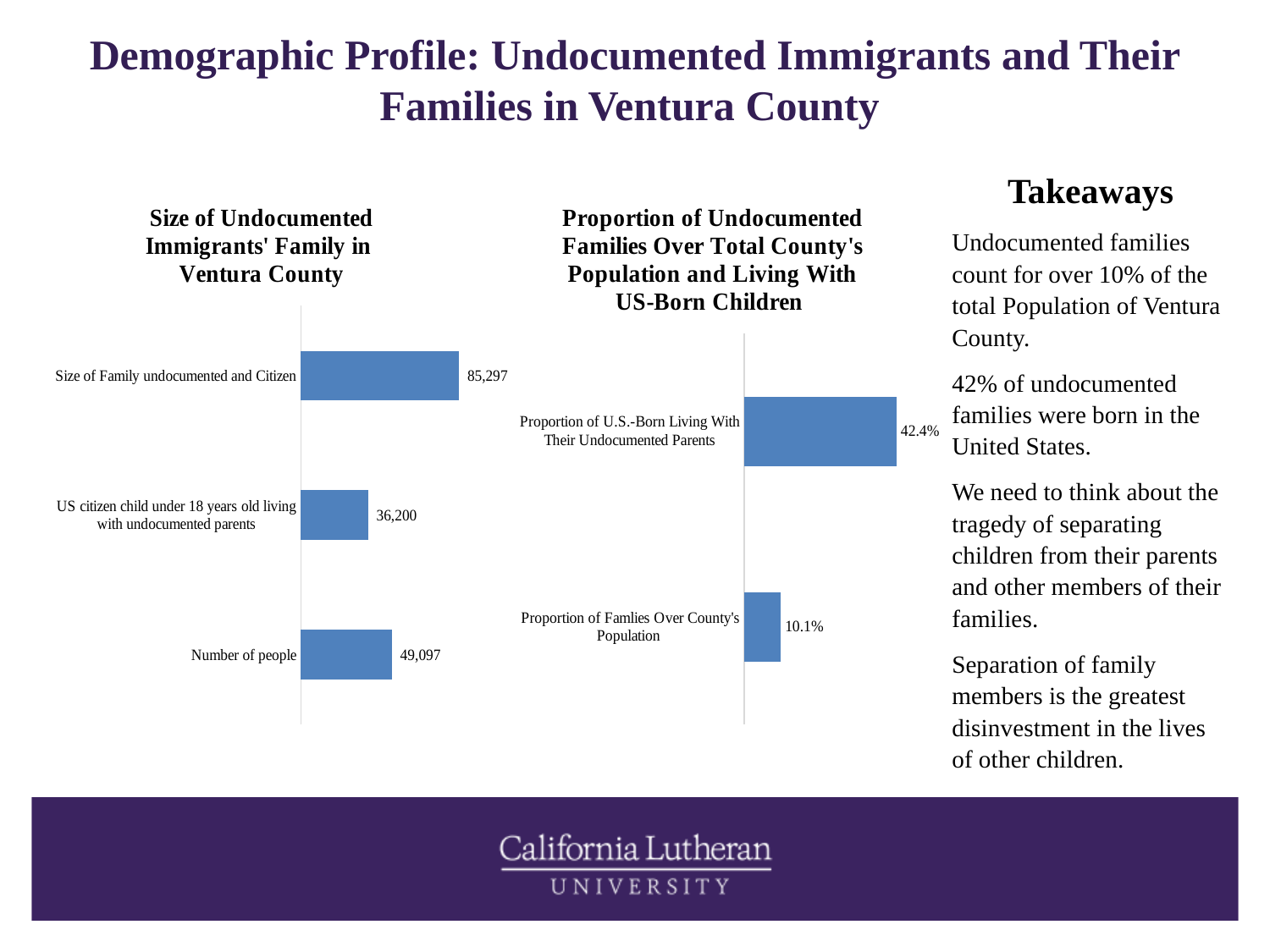
What type of chart is the 'Size of Undocumented Immigrants' Family in Ventura County' chart? Bar chart In the 'Size of Undocumented Immigrants' Family in Ventura County' chart, what is the value for 'Size of Family undocumented and Citizen'? 85,297 In the 'Size of Undocumented Immigrants' Family in Ventura County' chart, what is the value for 'Number of people'? 49,097 In the 'Proportion of Undocumented Families Over Total County's Population and Living With US-Born Children' chart, what is the value for 'Proportion of Famlies Over County's Population'? 10.1% In the 'Size of Undocumented Immigrants' Family in Ventura County' chart, how many categories are shown? 3 In the 'Size of Undocumented Immigrants' Family in Ventura County' chart, which category has the highest value? Size of Family undocumented and Citizen In the 'Size of Undocumented Immigrants' Family in Ventura County' chart, what is the value for 'US citizen child under 18 years old living with undocumented parents'? 36,200 In the 'Size of Undocumented Immigrants' Family in Ventura County' chart, which category has the lowest value? US citizen child under 18 years old living with undocumented parents In the 'Proportion of Undocumented Families Over Total County's Population and Living With US-Born Children' chart, what is the difference between the two values? 32.3% In the 'Proportion of Undocumented Families Over Total County's Population and Living With US-Born Children' chart, what is the value for 'Proportion of U.S.-Born Living With Their Undocumented Parents'? 42.4% In the 'Proportion of Undocumented Families Over Total County's Population and Living With US-Born Children' chart, which category has the larger value? Proportion of U.S.-Born Living With Their Undocumented Parents In the 'Size of Undocumented Immigrants' Family in Ventura County' chart, what is the difference between 'Size of Family undocumented and Citizen' and 'Number of people'? 36,200